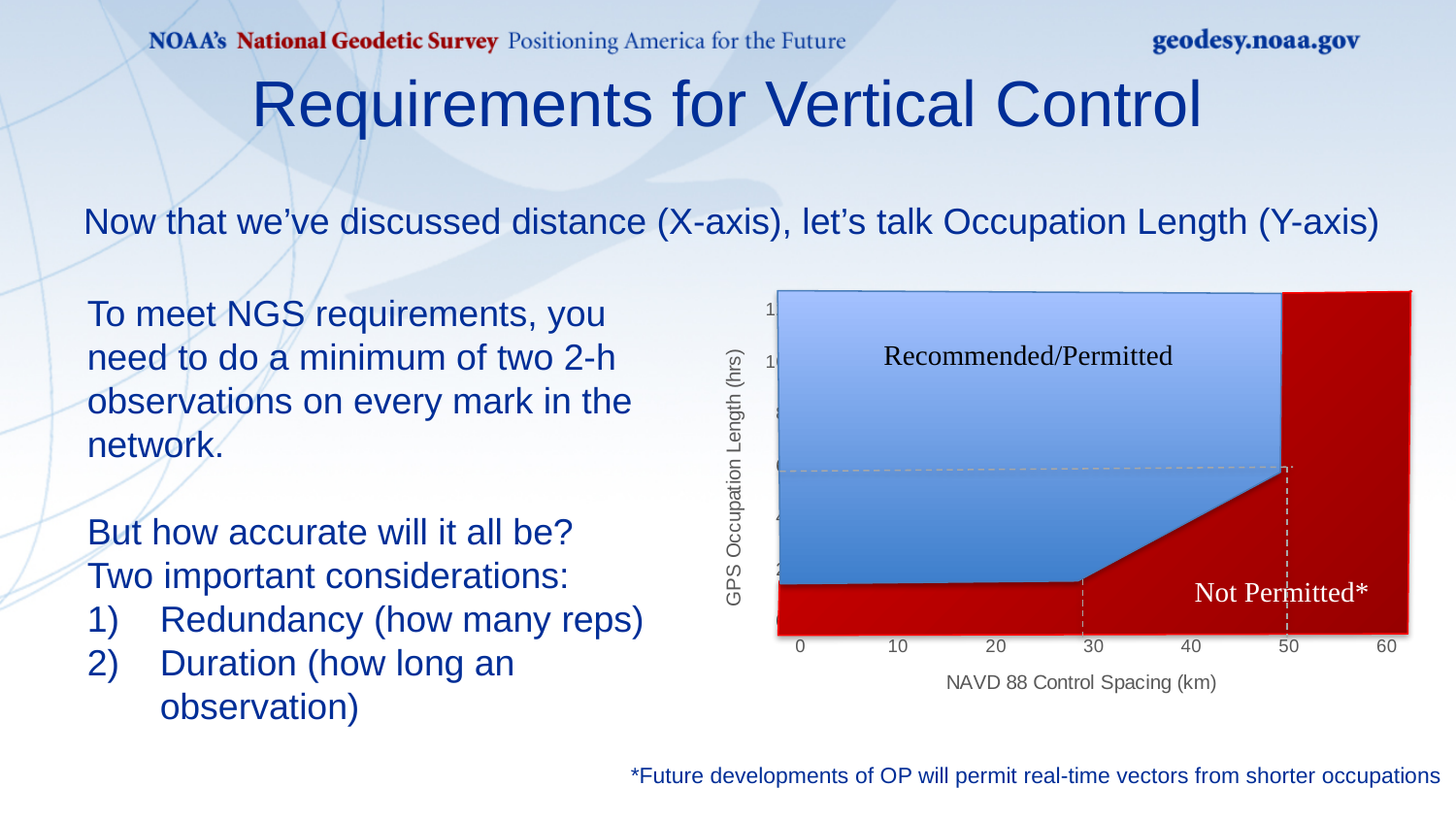
What kind of chart is shown on the slide? Area chart How many tick labels are shown on the x-axis of the chart? 7 What label is shown on the blue region of the chart? Recommended/Permitted What is the largest value shown on the x-axis of the chart? 60 Which region covers the larger area of the chart, Recommended/Permitted or Not Permitted? Recommended/Permitted As NAVD 88 control spacing increases beyond 30 km, does the minimum GPS occupation length required for the Recommended/Permitted region rise or fall? rise What is the title of the x-axis of the chart? NAVD 88 Control Spacing (km) At a control spacing of 20 km, is the minimum occupation length at the boundary of the Recommended/Permitted region greater or less than 4 hrs? less